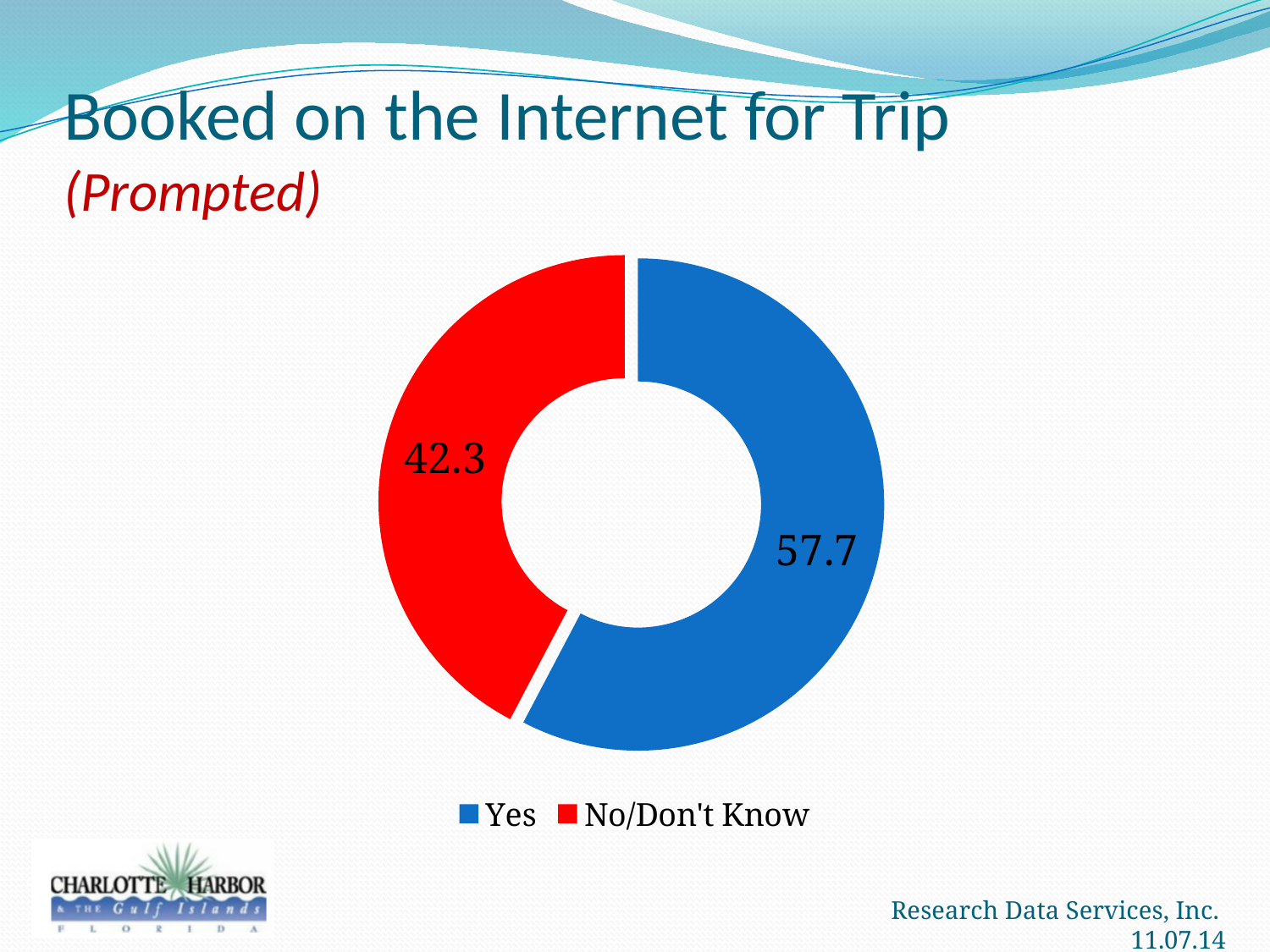
What is the value for No/Don't Know? 42.3 How many categories does the chart show? 2 Which category has the largest share? Yes What is the value for Yes? 57.7 Which is larger, Yes or No/Don't Know? Yes How many entries does the legend list? 2 What colour represents the Yes category? Blue What is the total of the two values shown? 100 What is the title of the chart? Booked on the Internet for Trip (Prompted) What is the difference between the Yes and No/Don't Know values? 15.4 What kind of chart is shown on the slide? Doughnut (pie) chart Which category has the smallest share? No/Don't Know